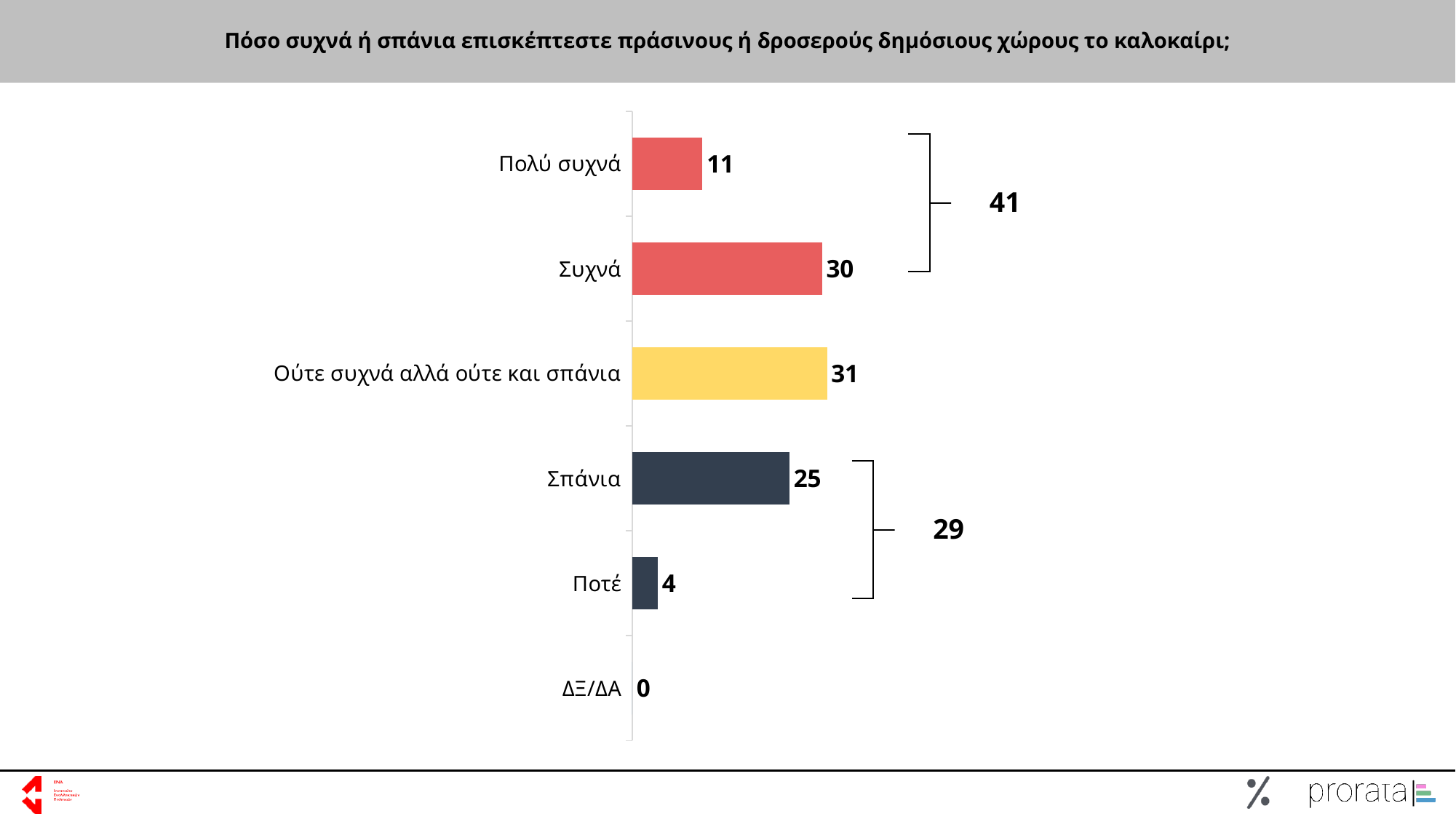
What is the difference between the values for Σπάνια and Πολύ συχνά? 14 How many categories are shown in the chart? 6 Which category has the lowest value? ΔΞ/ΔΑ What is the value for Ούτε συχνά αλλά ούτε και σπάνια? 31 What is the value for Συχνά? 30 What kind of chart is shown on the slide? Bar chart Which is larger, the value for Συχνά or the value for Σπάνια? Συχνά What is the value for Ποτέ? 4 What combined value is shown by the bracket grouping Πολύ συχνά and Συχνά? 41 Which category has the highest value? Ούτε συχνά αλλά ούτε και σπάνια What is the value for ΔΞ/ΔΑ? 0 What combined value is shown by the bracket grouping Σπάνια and Ποτέ? 29